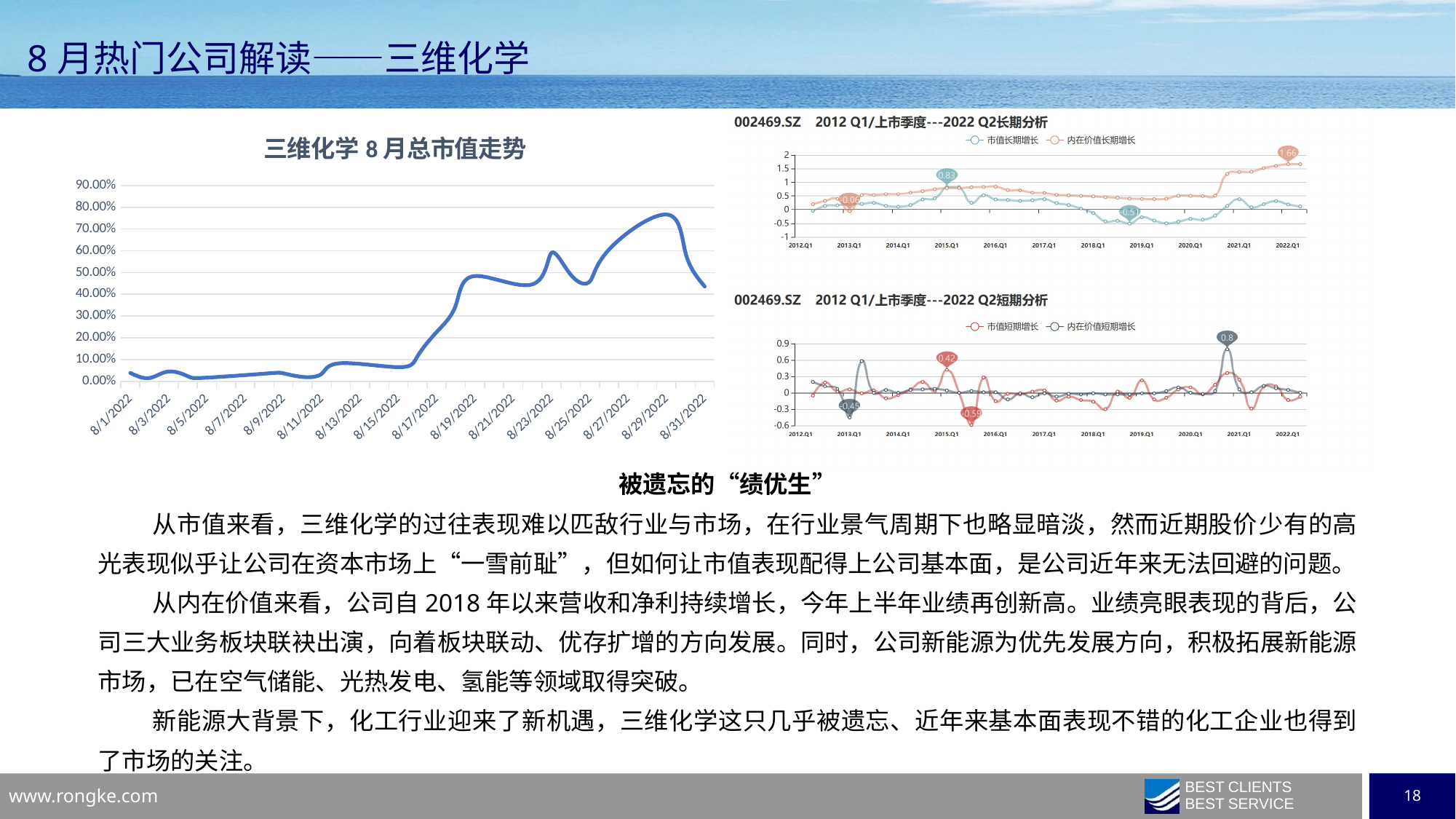
In the top-right chart 002469.SZ 长期分析, what is the highest labeled value of the 内在价值长期增长 series? 1.66 In the left chart 三维化学 8 月总市值走势, is the value on 8/31/2022 greater or less than 50.00%? less In the bottom-right chart 002469.SZ 短期分析, what is the lowest labeled value? -0.59 In the left chart 三维化学 8 月总市值走势, is the value on 8/1/2022 greater or less than 10.00%? less How many date labels are shown on the x axis of the left chart 三维化学 8 月总市值走势? 16 In the left chart 三维化学 8 月总市值走势, is the value on 8/29/2022 greater or less than 70.00%? greater In the bottom-right chart 002469.SZ 2012 Q1/上市季度---2022 Q2短期分析, what is the highest labeled value? 0.8 In the bottom-right chart 002469.SZ 短期分析, which labeled value is larger, 0.42 or 0.8? 0.8 In the top-right chart 002469.SZ 长期分析, what is the difference between the labeled values 1.66 and 0.83? 0.83 What kind of chart is the left chart titled 三维化学 8 月总市值走势? line chart In the left chart 三维化学 8 月总市值走势, do the values overall rise or fall from 8/1/2022 to 8/31/2022? rise How many series does the legend list in the top-right chart 002469.SZ 2012 Q1/上市季度---2022 Q2长期分析? 2